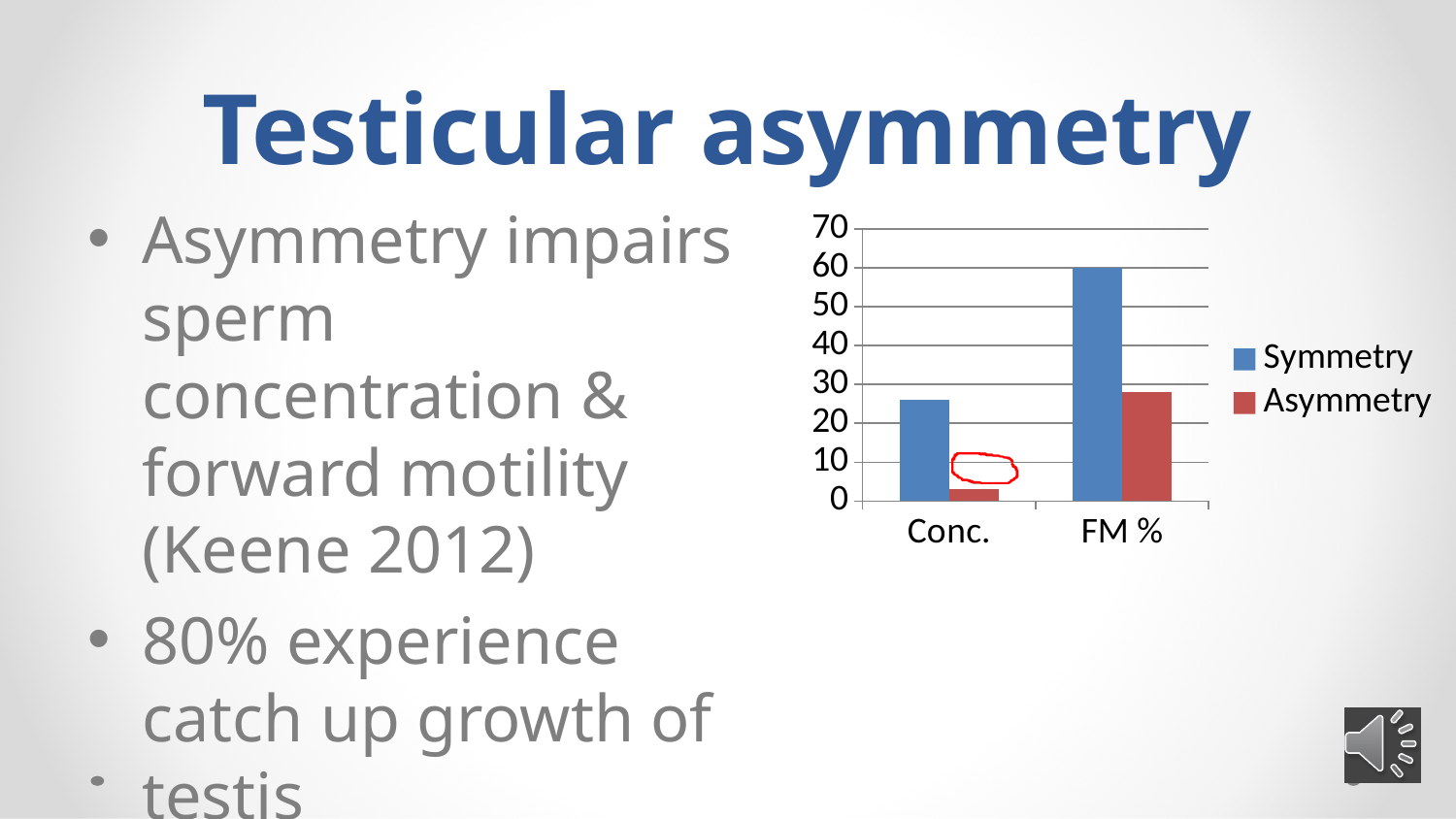
Which series is shown in red in the chart? Asymmetry Which series is shown in blue in the chart? Symmetry What kind of chart is shown on the slide? bar chart Which category has the highest Symmetry value? FM % Is the Asymmetry value for Conc. greater or less than 10? less For the Conc. category, which series has the larger value, Symmetry or Asymmetry? Symmetry How many series does the chart's legend list? 2 How many categories are shown on the x axis of the chart? 2 Is the Asymmetry value for FM % greater or less than 40? less Is the Symmetry value for Conc. greater or less than 20? greater For the FM % category, which series has the larger value, Symmetry or Asymmetry? Symmetry